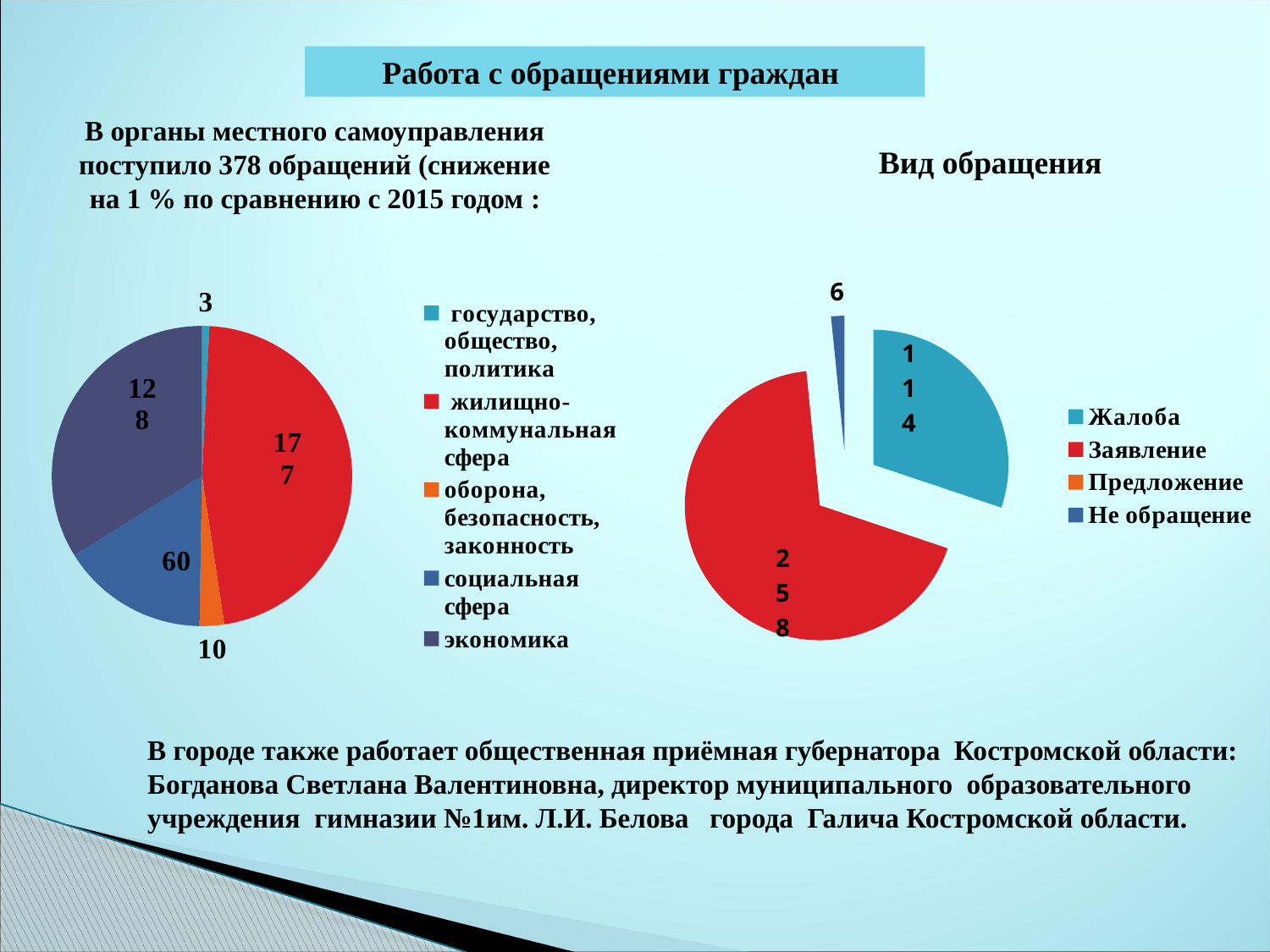
In the chart titled 'Вид обращения', which is larger, Жалоба or Не обращение? Жалоба In the left pie chart, what is the difference between the values for экономика and социальная сфера? 68 In the chart titled 'Вид обращения', which category has the largest slice? Заявление In the chart titled 'Вид обращения', what is the value for Заявление? 258 In the left pie chart, what is the value for социальная сфера? 60 In the left pie chart, what is the value for жилищно-коммунальная сфера? 177 In the left pie chart, which category has the largest slice? жилищно-коммунальная сфера How many categories does the legend of the left pie chart list? 5 What type of chart is the chart titled 'Вид обращения'? pie chart In the chart titled 'Вид обращения', what is the value for Жалоба? 114 In the left pie chart, what is the value for экономика? 128 In the left pie chart, which category has the smallest slice? государство, общество, политика